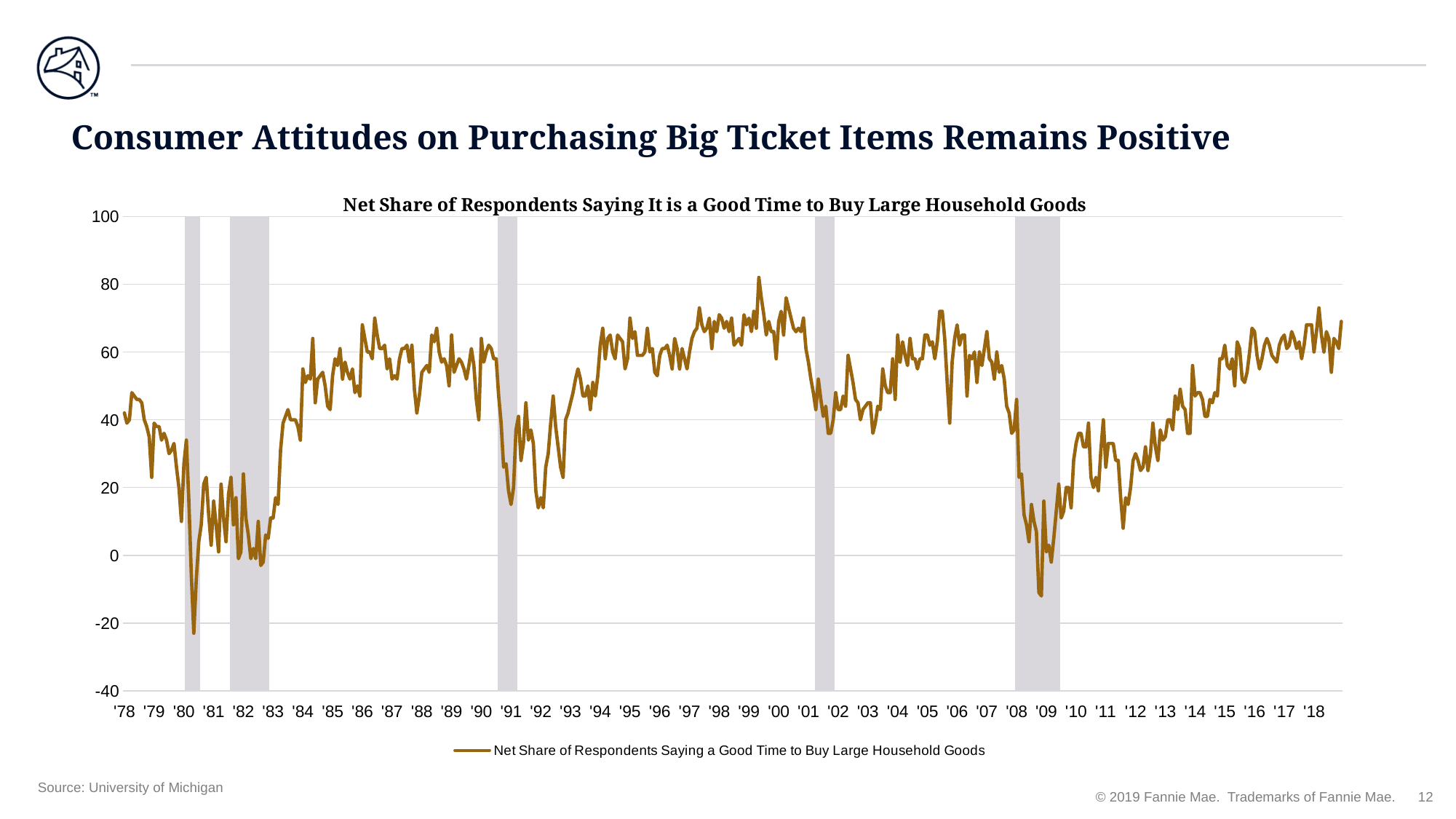
What is the legend entry for the plotted line? Net Share of Respondents Saying a Good Time to Buy Large Household Goods Is the value at the end of the series in '18 greater or less than 40? greater What is the title of the chart? Net Share of Respondents Saying It is a Good Time to Buy Large Household Goods What kind of chart is shown on the slide? line chart Is the peak value reached around '99 greater or less than 60? greater Is the lowest value reached around '80 greater or less than 0? less Does the line generally rise or fall from '09 to '18? rise Around which year does the line reach its highest point? '99 Around which year does the line reach its lowest point? '80 How many series does the legend list? 1